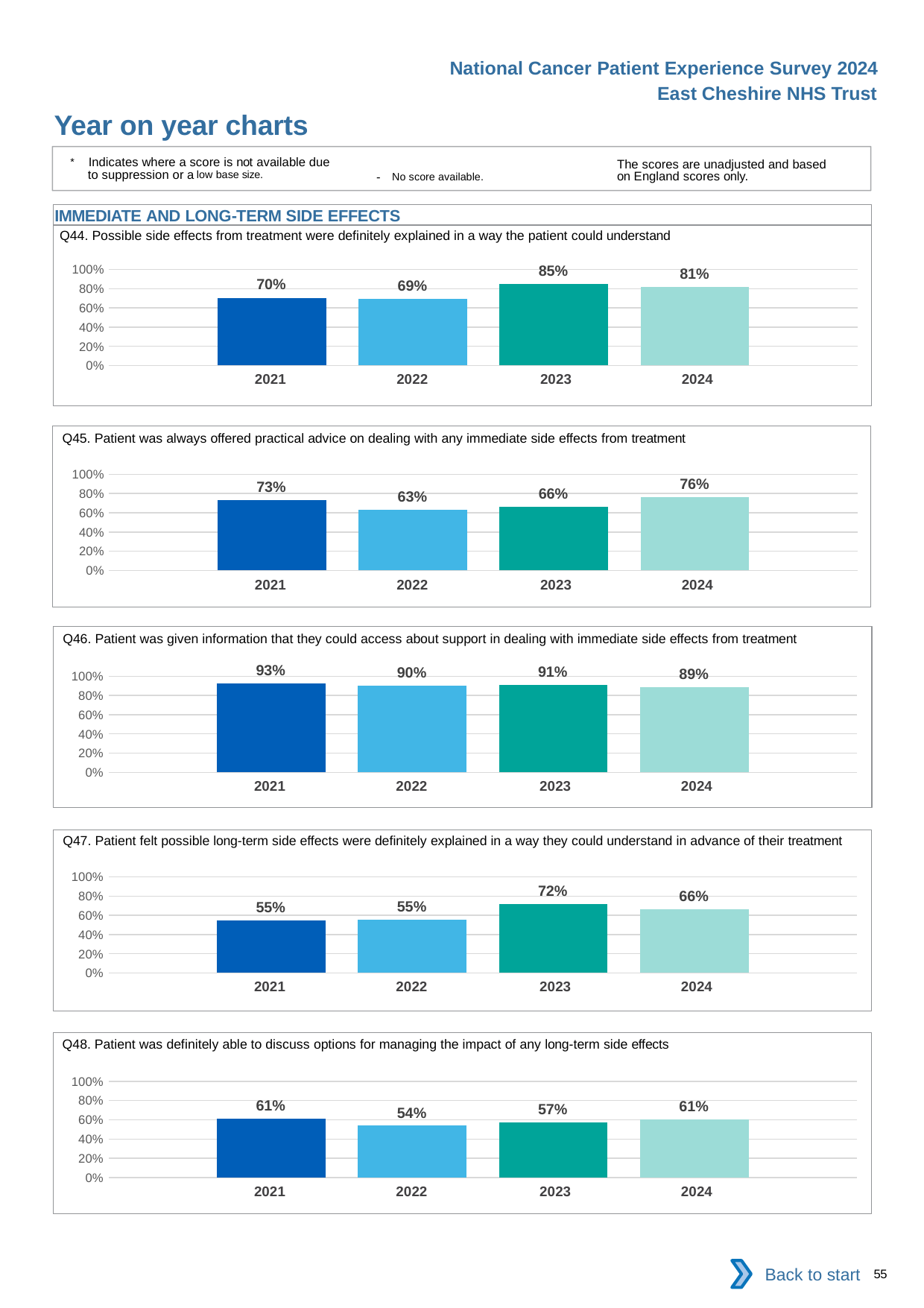
In the Q47 chart, which is larger, the value for 2023 or the value for 2024? 2023 In the Q45 chart, what is the difference between the 2024 and 2023 values? 10% In the Q48 chart, which year has the highest value, 2022 or 2023? 2023 In the Q45 chart, which year has the lowest value? 2022 In the Q44 chart, what is the value for 2023? 85% In the Q44 chart, which year has the highest value? 2023 In the Q48 chart, what is the value for 2022? 54% In the Q47 chart, is the value for 2021 greater or less than 60%? less How many years are shown on the x axis of the Q46 chart? 4 In the Q46 chart, what is the difference between the 2021 and 2024 values? 4% In the Q46 chart, what is the value for 2022? 90% What kind of chart is the Q47 chart? bar chart